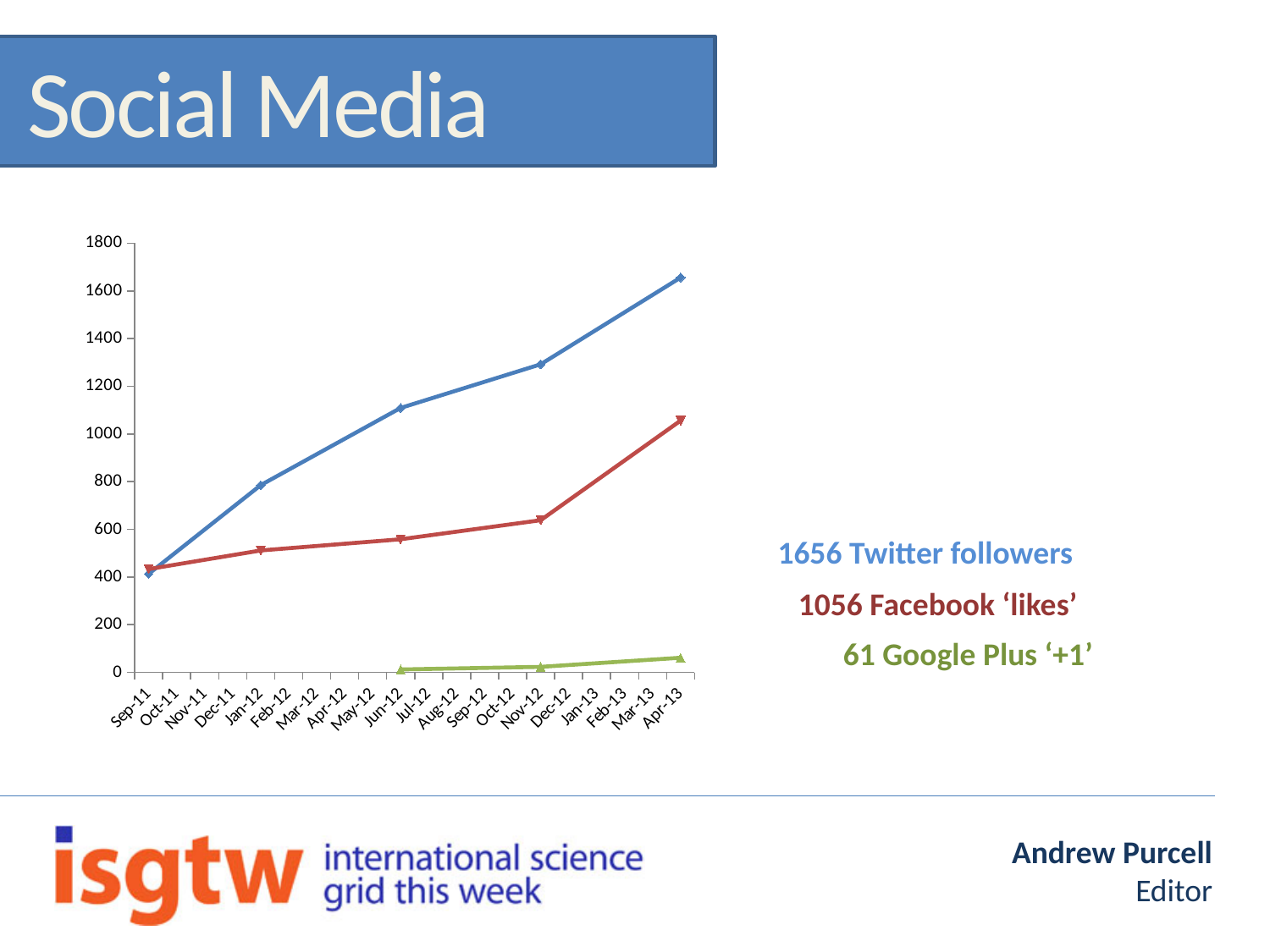
How many Google Plus '+1' are reported at the end of the period (Apr-13)? 61 Which series has the highest value at Apr-13? Twitter followers Which series has the lowest value at Apr-13? Google Plus '+1' What colour is the line representing Twitter followers? blue Is the value of the Facebook 'likes' line at Nov-12 greater or less than 800? less What kind of chart is shown on the slide? line chart What is the difference between the Twitter followers (1656) and Facebook 'likes' (1056) figures? 600 Does the Twitter followers line rise or fall from Sep-11 to Apr-13? rise How many Twitter followers are reported at the end of the period (Apr-13)? 1656 Is the value of the Twitter followers line at Nov-12 greater or less than 1200? greater How many month labels are shown on the x axis? 20 How many Facebook 'likes' are reported at the end of the period (Apr-13)? 1056